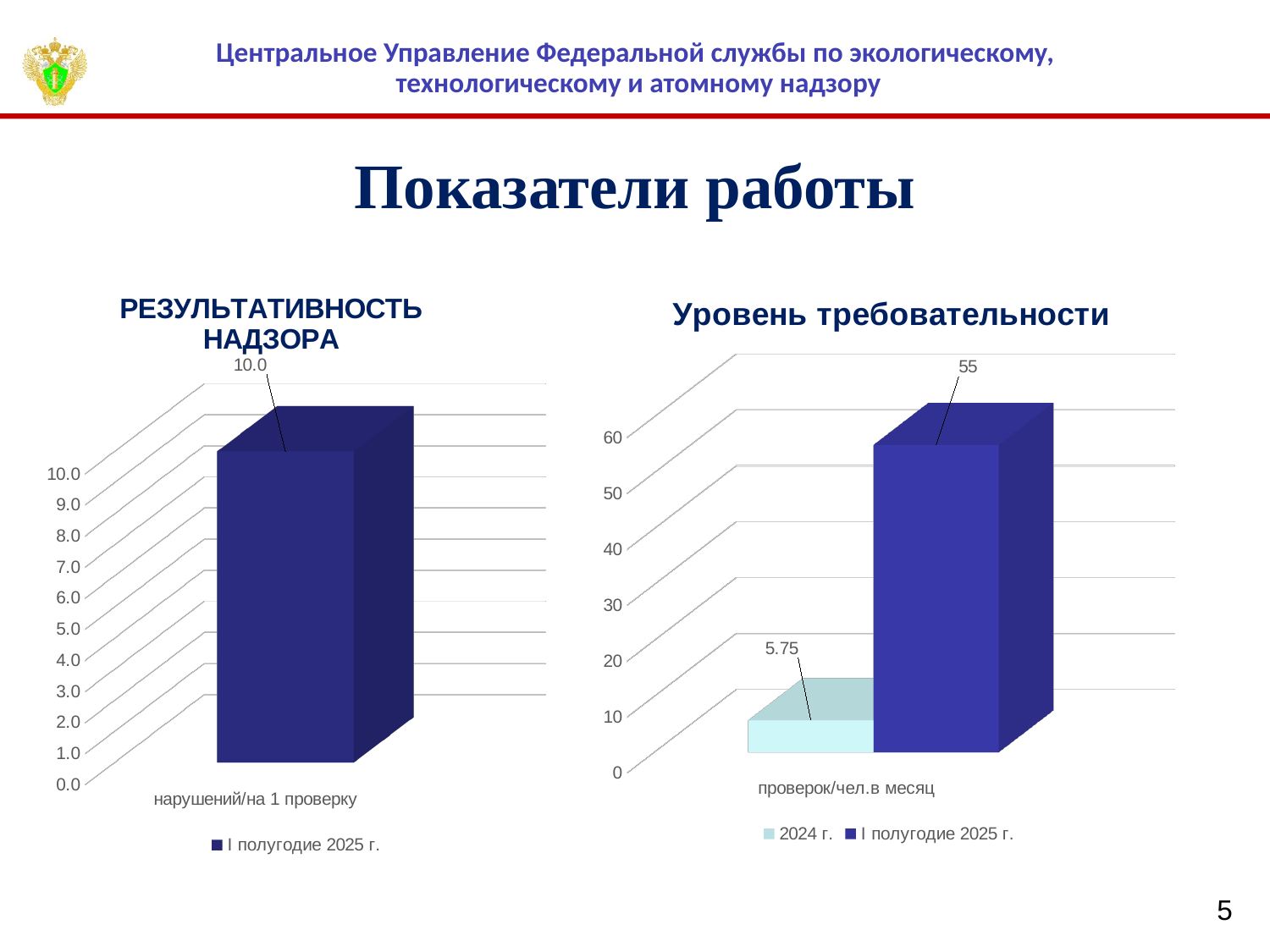
In the 'РЕЗУЛЬТАТИВНОСТЬ НАДЗОРА' chart, what is the value for 'нарушений/на 1 проверку' for 'I полугодие 2025 г.'? 10.0 In the 'Уровень требовательности' chart, what is the difference between the 'I полугодие 2025 г.' value and the '2024 г.' value? 49.25 In the 'Уровень требовательности' chart, is the value for '2024 г.' greater or less than 10? less In the 'РЕЗУЛЬТАТИВНОСТЬ НАДЗОРА' chart, what is the category label on the x axis? нарушений/на 1 проверку In the 'Уровень требовательности' chart, which series has the higher value? I полугодие 2025 г. What kind of chart is the 'РЕЗУЛЬТАТИВНОСТЬ НАДЗОРА' chart? bar chart In the 'Уровень требовательности' chart, what is the category label on the x axis? проверок/чел.в месяц In the 'Уровень требовательности' chart, what is the value for '2024 г.'? 5.75 What kind of chart is the 'Уровень требовательности' chart? bar chart In the 'РЕЗУЛЬТАТИВНОСТЬ НАДЗОРА' chart, how many series does the legend list? 1 In the 'Уровень требовательности' chart, what is the value for 'I полугодие 2025 г.'? 55 In the 'Уровень требовательности' chart, how many series does the legend list? 2